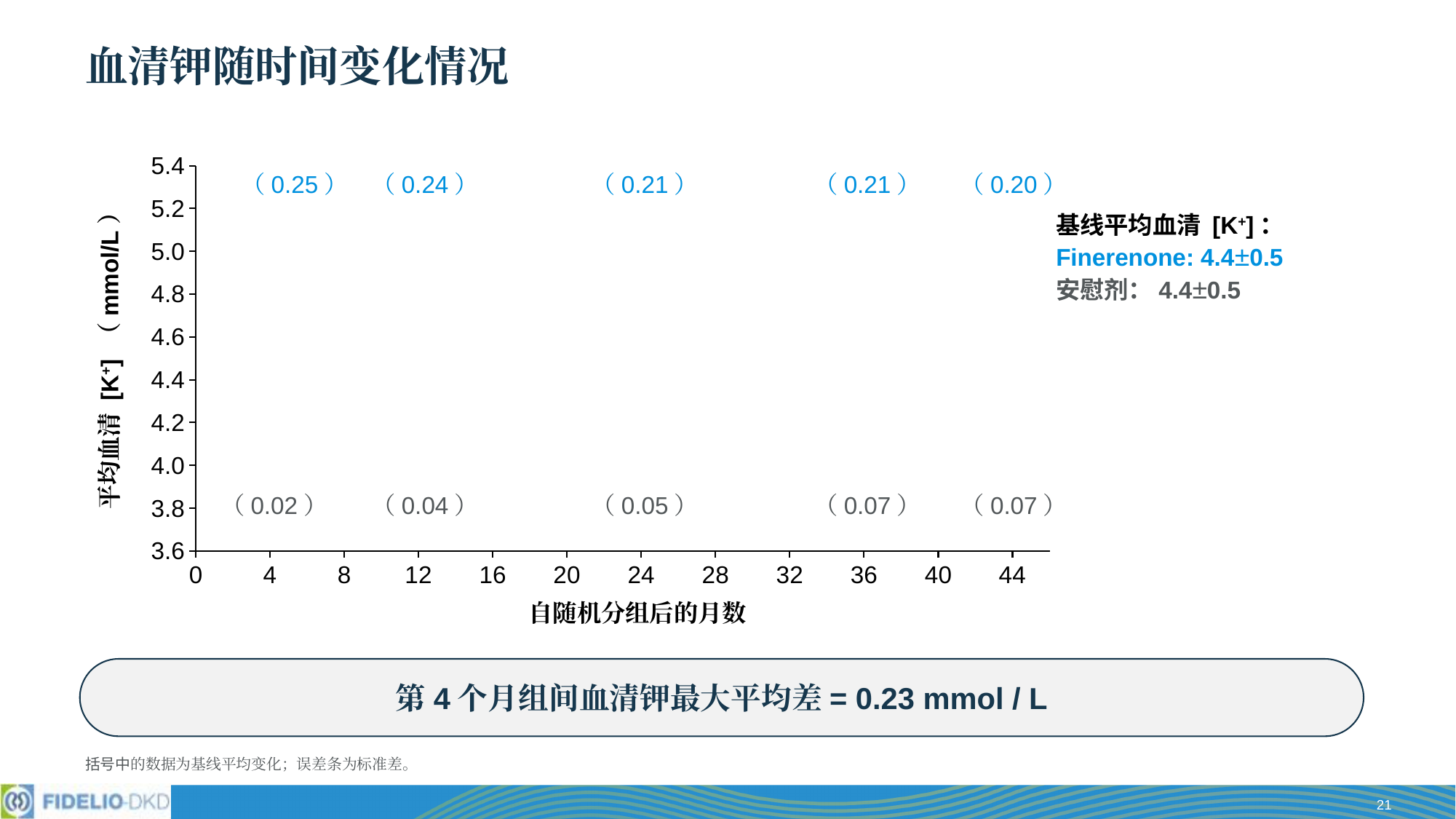
What is the last (rightmost) grey value in parentheses shown near the bottom of the chart? 0.07 According to the text beside the chart, what is the baseline mean serum [K+] for Finerenone? 4.4±0.5 What is the first (leftmost) grey value in parentheses shown near the bottom of the chart? 0.02 What is the difference between the leftmost blue value (0.25) and the leftmost grey value (0.02) in parentheses? 0.23 What is the title of the chart on the slide? 血清钾随时间变化情况 Which of the blue values in parentheses at the top of the chart is the highest? 0.25 What is the x-axis label of the chart? 自随机分组后的月数 How many blue values in parentheses are shown at the top of the chart? 5 What is the first (leftmost) blue value in parentheses shown at the top of the chart? 0.25 Which of the grey values in parentheses near the bottom of the chart is the lowest? 0.02 What is the last (rightmost) blue value in parentheses shown at the top of the chart? 0.20 Do the blue values in parentheses at the top of the chart rise or fall from left to right? fall